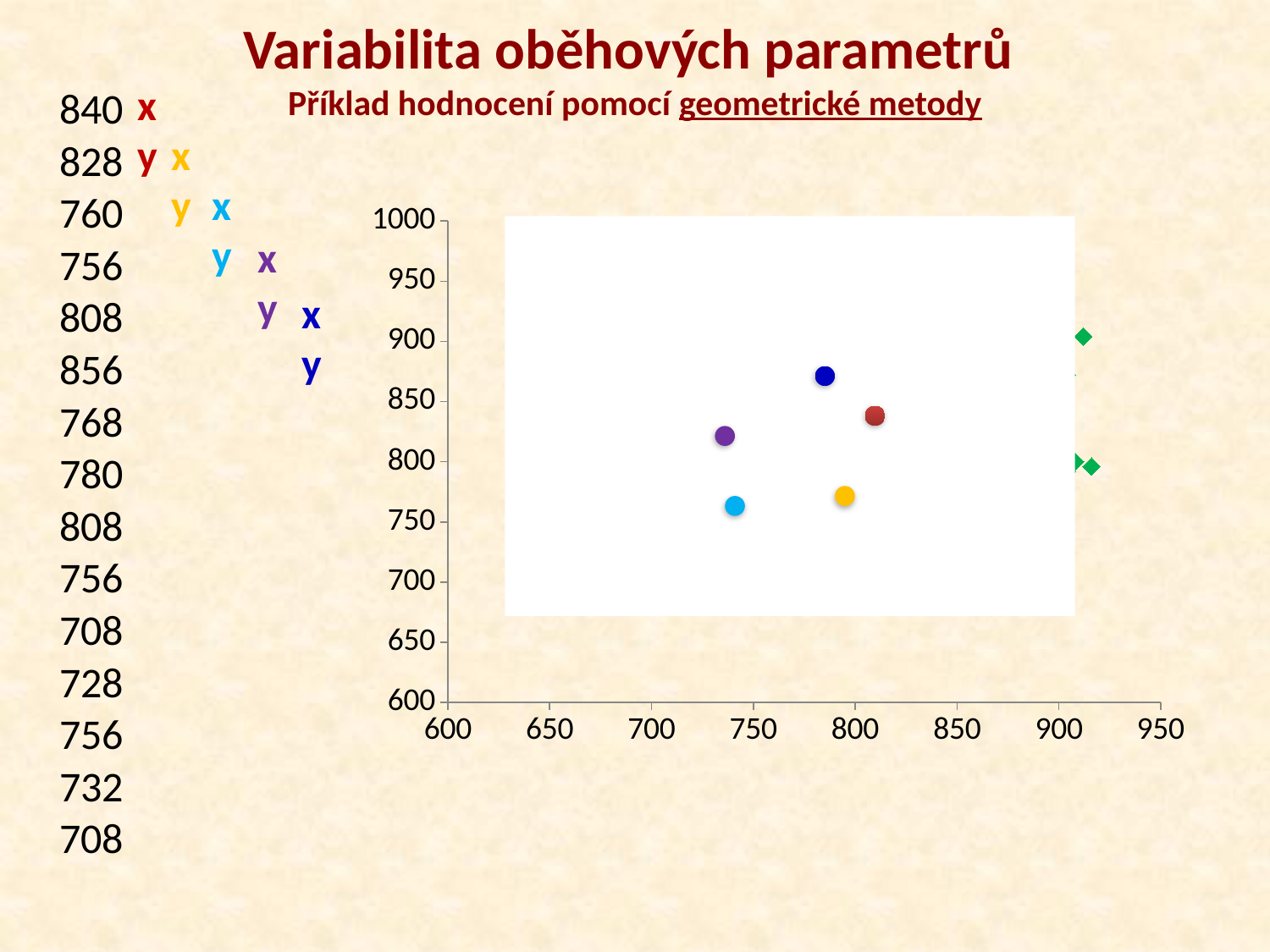
Which has the larger horizontal (x) value, the red point or the light blue point? the red point Which circular point has the highest vertical (y) value? the dark blue point How many large circular markers are plotted on the chart? 5 What kind of chart is shown on the slide? scatter chart What is the lowest value shown on the horizontal axis? 600 What is the highest value shown on the vertical axis? 1000 Is the vertical (y) value of the yellow point greater or less than 800? less Is the horizontal (x) value of the light blue point greater or less than 750? less Which has the higher vertical (y) value, the dark blue point or the yellow point? the dark blue point Is the horizontal (x) value of the red point greater or less than 800? greater